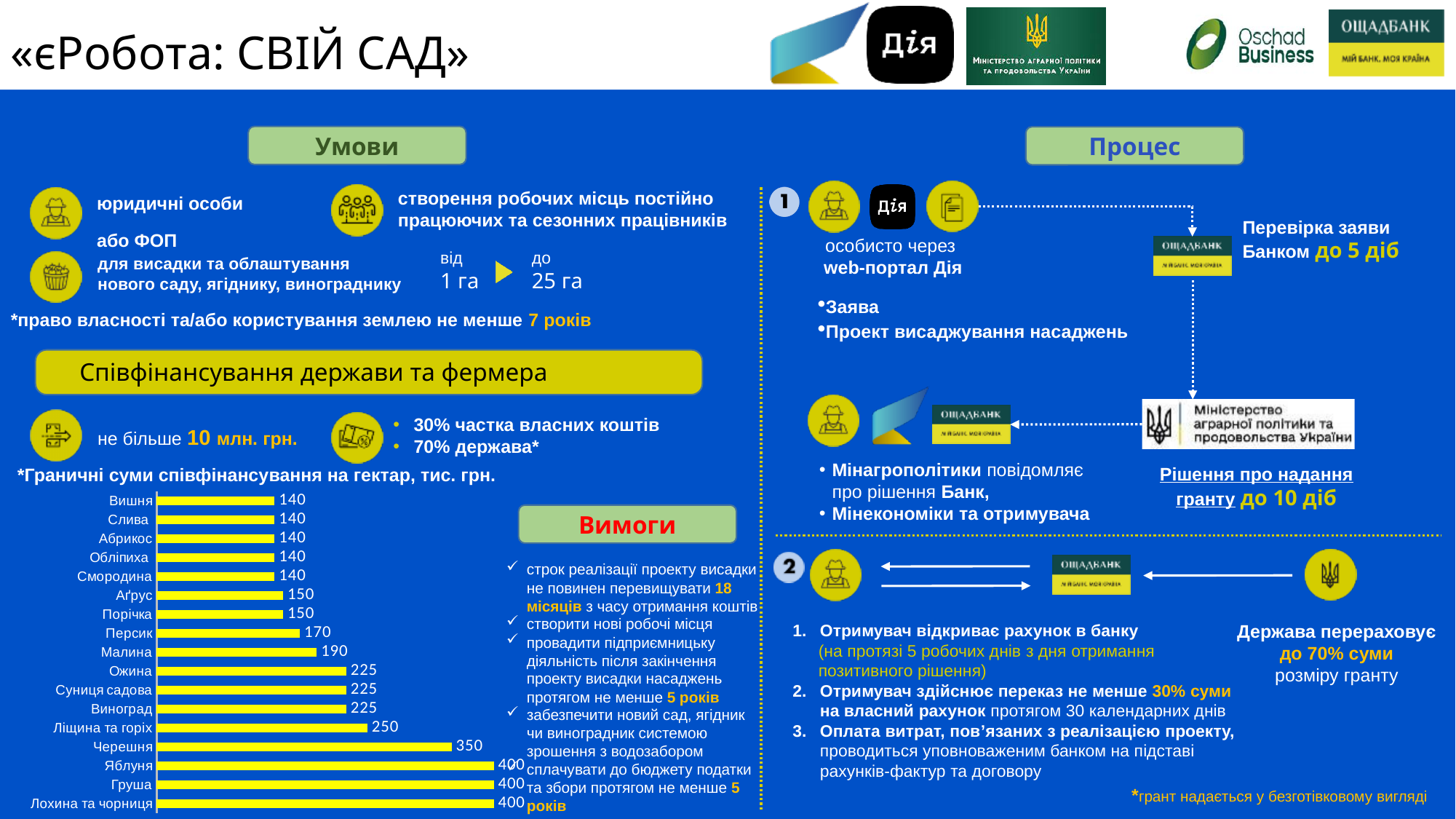
What is the highest value shown in the bar chart? 400 What is the lowest value shown in the bar chart? 140 Do the values in the bar chart increase or decrease going from Вишня at the top to Лохина та чорниця at the bottom? increase How many categories are shown in the bar chart? 17 What is the value for Черешня in the bar chart? 350 What is the value for Малина in the bar chart? 190 What type of chart is shown on the slide? bar chart What is the value for Ліщина та горіх in the bar chart? 250 What is the value for Аґрус in the bar chart? 150 What is the value for Персик in the bar chart? 170 What is the difference between the values for Яблуня and Черешня? 50 Which has a larger value, Ожина or Малина? Ожина